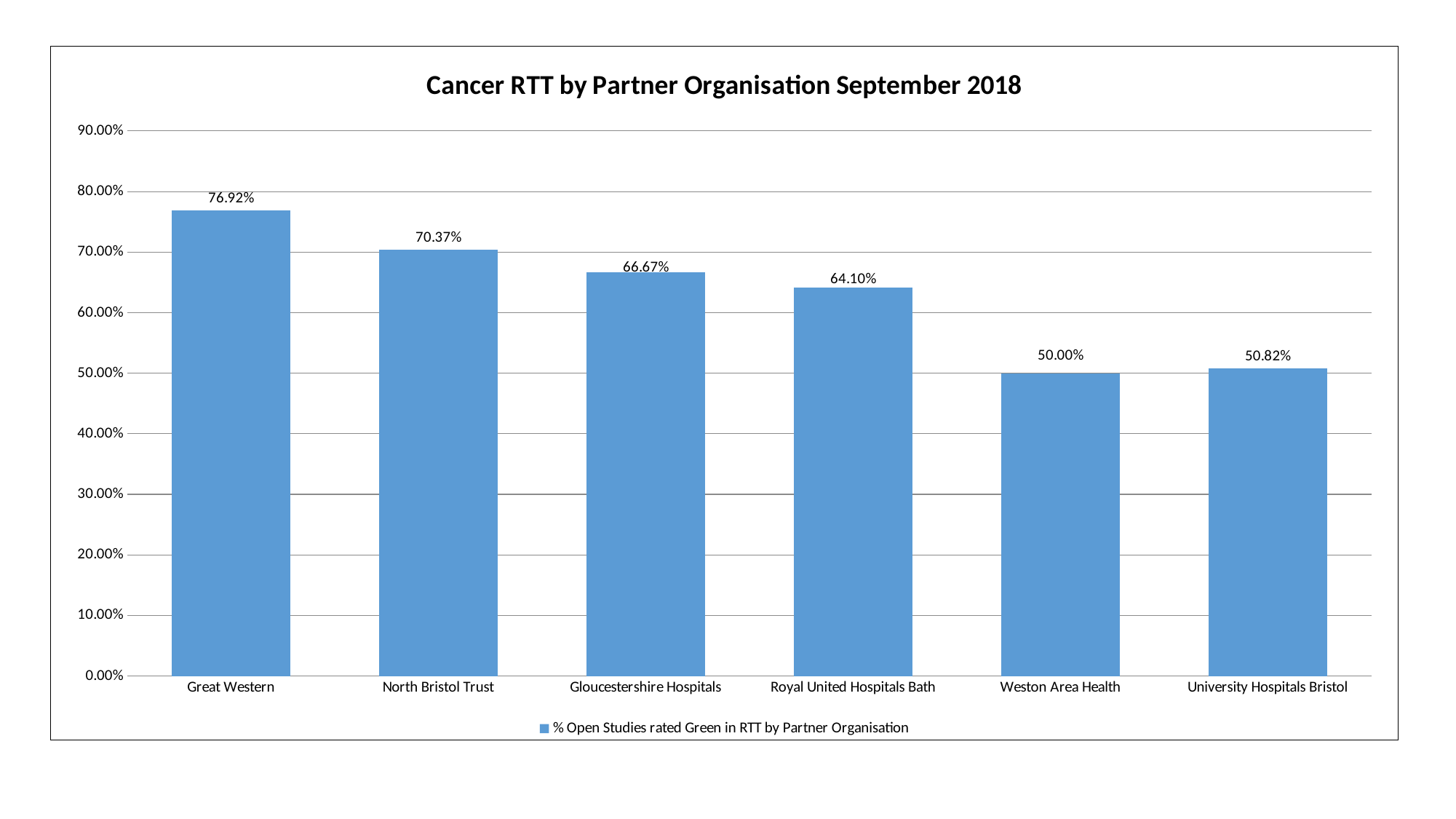
What is the title of the chart? Cancer RTT by Partner Organisation September 2018 What is the difference between the values for Great Western and North Bristol Trust? 6.55% Is the value for Royal United Hospitals Bath greater or less than 60.00%? greater What is the value for University Hospitals Bristol? 50.82% How many partner organisations are shown on the chart? 6 Which is larger, the value for North Bristol Trust or the value for Gloucestershire Hospitals? North Bristol Trust Which partner organisation has the lowest value? Weston Area Health Which partner organisation has the highest value? Great Western What kind of chart is shown on the slide? Bar chart What is the value for Great Western? 76.92% What is the difference between the values for Gloucestershire Hospitals and Royal United Hospitals Bath? 2.57% What is the value for Royal United Hospitals Bath? 64.10%